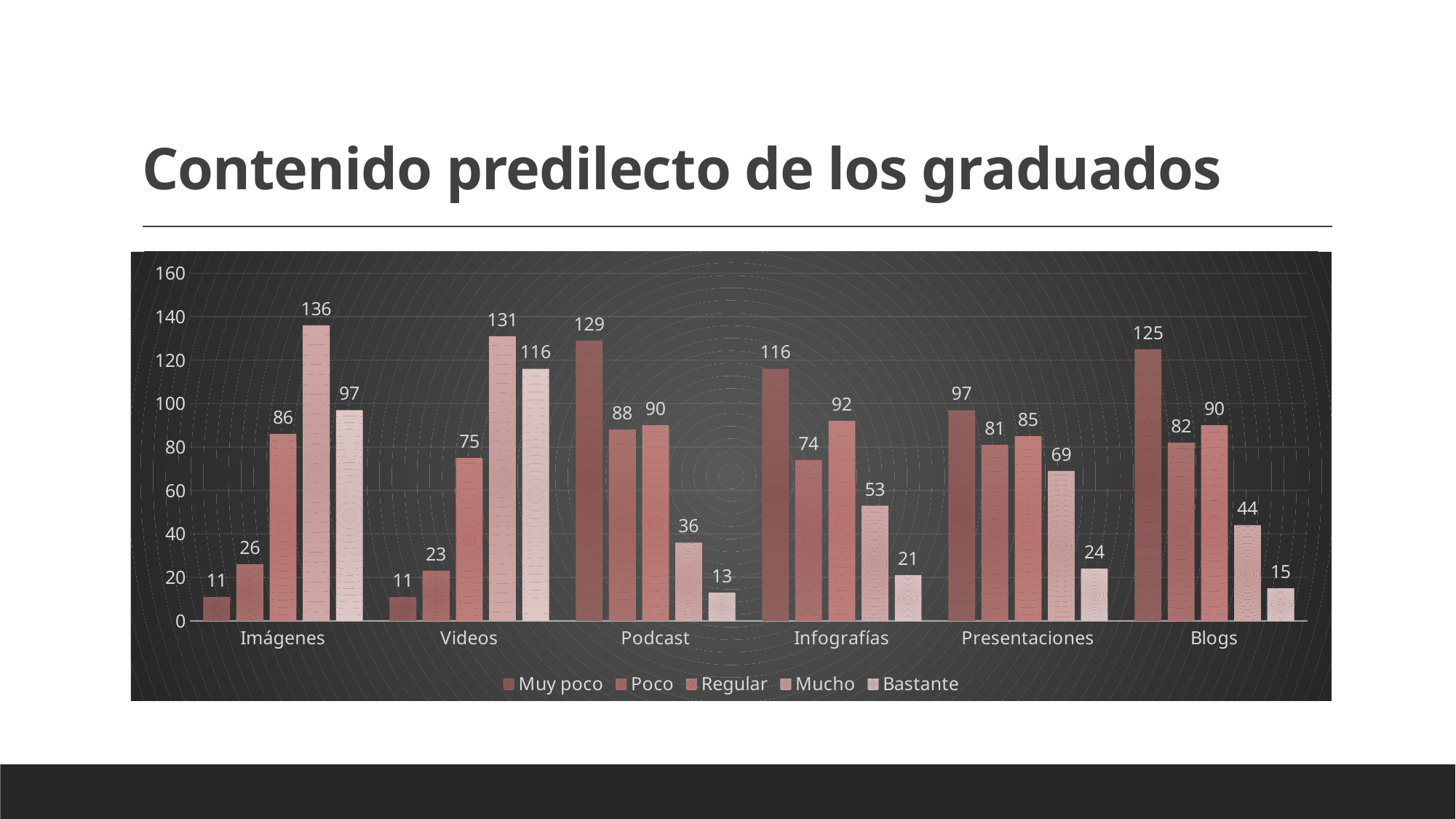
What is the value for "Bastante" in the Videos category? 116 How many categories are shown on the x axis? 6 What is the title of the slide? Contenido predilecto de los graduados Does the "Muy poco" series rise or fall from Imágenes to Podcast? Rise Which category has the lowest value for the "Mucho" series? Podcast What is the value for "Mucho" in the Imágenes category? 136 How many series does the legend list? 5 Which is larger: the "Regular" value for Infografías or the "Regular" value for Presentaciones? Infografías What is the value for "Muy poco" in the Podcast category? 129 What is the difference between the "Muy poco" values for Podcast and Blogs? 4 Which category has the highest value for the "Bastante" series? Videos What kind of chart is shown on the slide? Bar chart